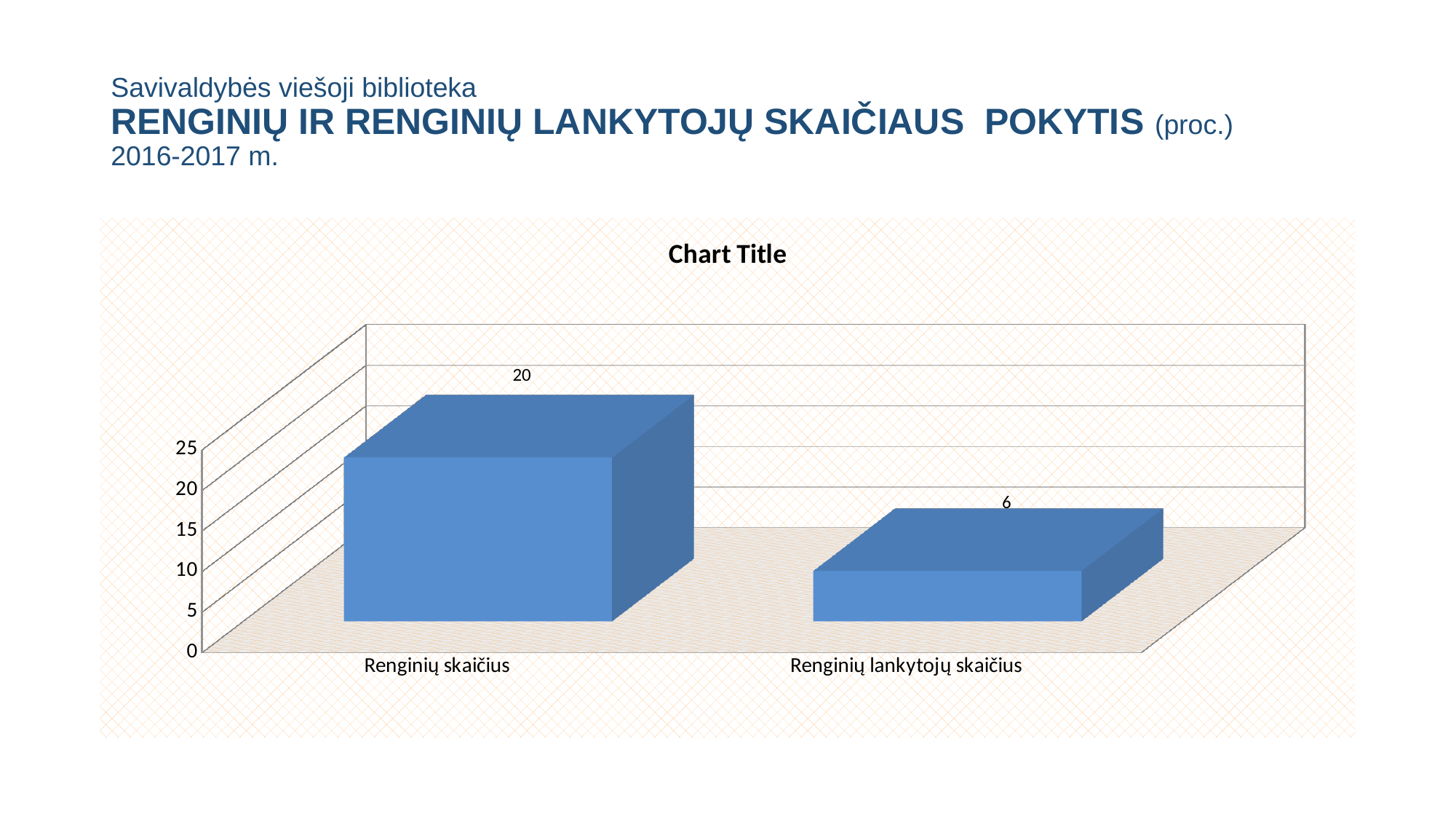
What is the value for Renginių lankytojų skaičius? 6 What kind of chart is shown on the slide? bar chart What is the highest value shown on the vertical axis? 25 Which category has the lowest value? Renginių lankytojų skaičius Which category has the highest value? Renginių skaičius What is the value for Renginių skaičius? 20 What is the title shown above the chart? Chart Title Is the value for Renginių lankytojų skaičius greater or less than 10? less Which is larger, the value for Renginių skaičius or the value for Renginių lankytojų skaičius? Renginių skaičius What is the difference between the values for Renginių skaičius and Renginių lankytojų skaičius? 14 How many categories are shown on the chart? 2 Is the value for Renginių skaičius greater or less than 15? greater